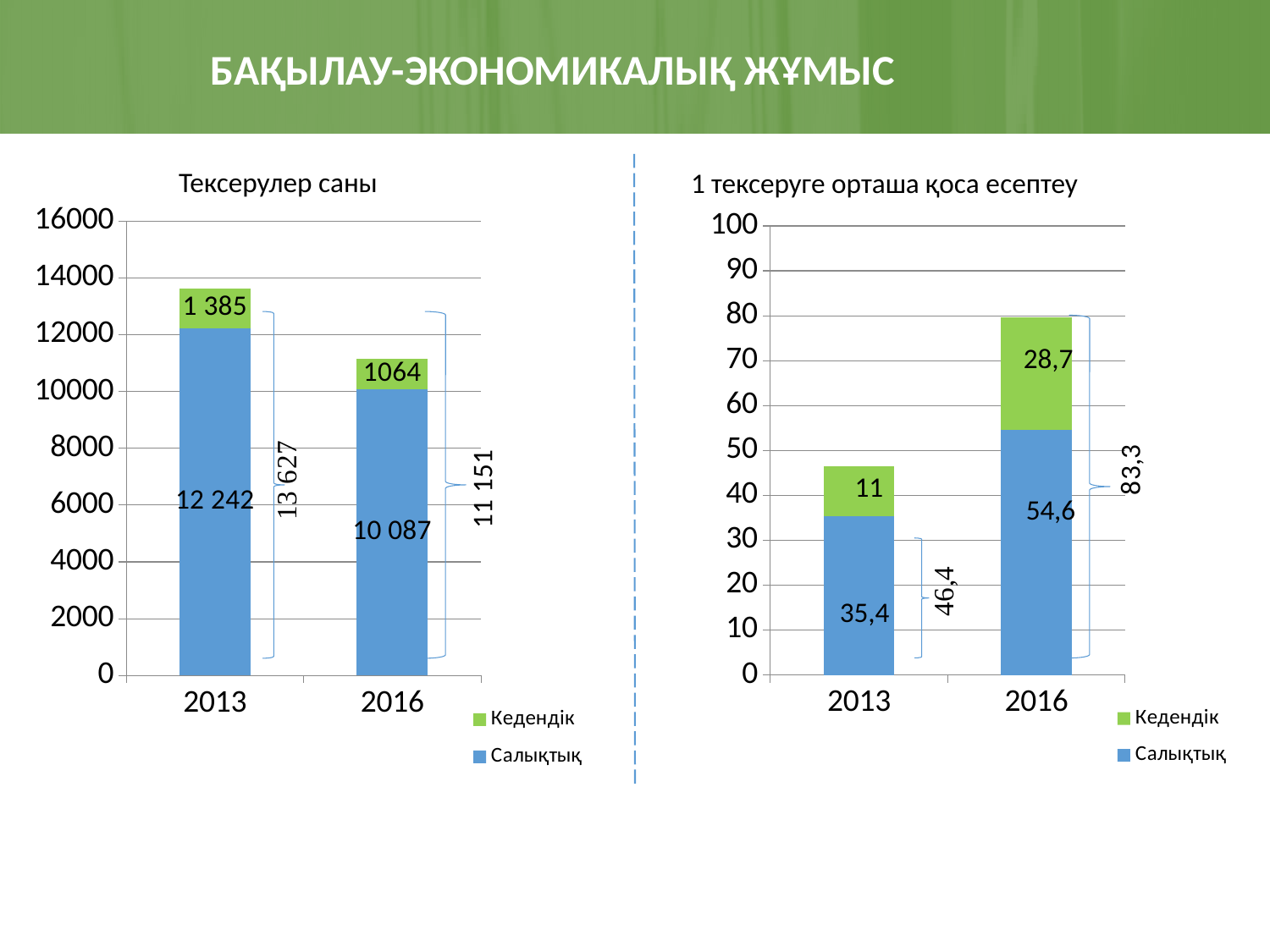
In the chart titled '1 тексеруге орташа қоса есептеу', what is the total of the stacked bar for 2013? 46,4 How many series does the legend of the chart titled 'Тексерулер саны' list? 2 What kind of chart is the chart titled '1 тексеруге орташа қоса есептеу'? stacked bar chart In the chart titled 'Тексерулер саны', which year has the higher total? 2013 In the chart titled '1 тексеруге орташа қоса есептеу', do the totals rise or fall from 2013 to 2016? rise In the chart titled '1 тексеруге орташа қоса есептеу', what is the difference between the Кедендік values for 2016 and 2013? 17,7 In the chart titled 'Тексерулер саны', what is the difference between the Салықтық values for 2013 and 2016? 2 155 In the chart titled 'Тексерулер саны', what is the value of Салықтық for 2013? 12 242 In the chart titled '1 тексеруге орташа қоса есептеу', what is the value of Салықтық for 2013? 35,4 In the chart titled '1 тексеруге орташа қоса есептеу', what is the value of Кедендік for 2016? 28,7 In the chart titled 'Тексерулер саны', what is the total of the stacked bar for 2016? 11 151 In the chart titled 'Тексерулер саны', what is the value of Кедендік for 2016? 1064